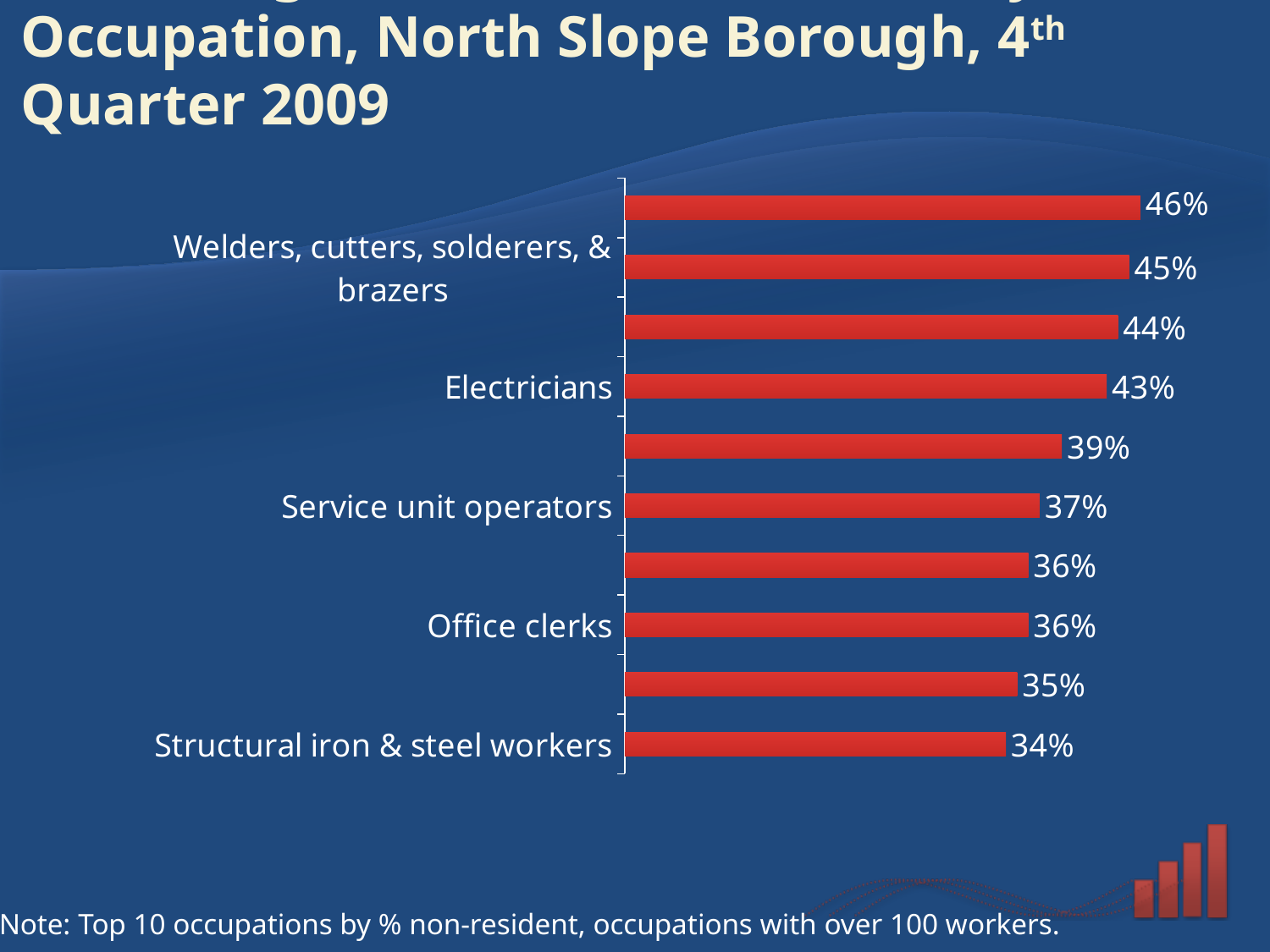
What colour are the bars on the chart? Red Which is larger, the value for Electricians or the value for Service unit operators? Electricians What is the value for Office clerks? 36% What is the value for Service unit operators? 37% What is the value for Welders, cutters, solderers, & brazers? 45% What is the highest value shown on the chart? 46% What is the difference between the values for Electricians and Structural iron & steel workers? 9 percentage points Which of the labeled occupations has the lowest value? Structural iron & steel workers What is the value for Electricians? 43% How many bars are shown on the chart? 10 What kind of chart is shown on the slide? Bar chart What is the value for Structural iron & steel workers? 34%